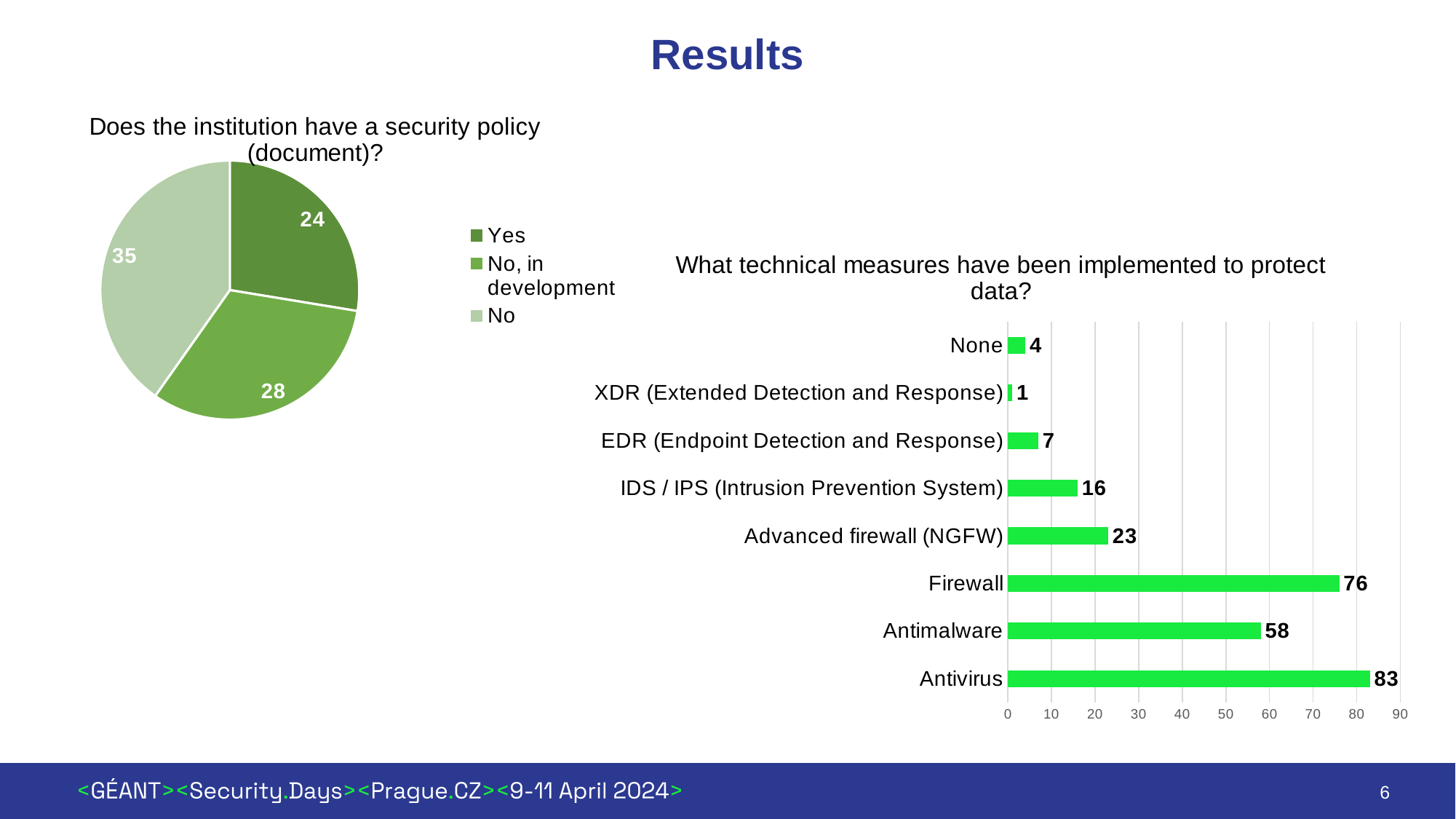
What kind of chart is 'What technical measures have been implemented to protect data?'? Bar chart In the bar chart 'What technical measures have been implemented to protect data?', what is the value for None? 4 In the bar chart 'What technical measures have been implemented to protect data?', which measure has the highest value? Antivirus In the pie chart 'Does the institution have a security policy (document)?', which category has the largest slice? No How many categories does the legend of the pie chart 'Does the institution have a security policy (document)?' list? 3 How many categories are shown in the bar chart 'What technical measures have been implemented to protect data?'? 8 In the bar chart 'What technical measures have been implemented to protect data?', what is the value for Firewall? 76 In the bar chart 'What technical measures have been implemented to protect data?', what is the difference between Antivirus and Antimalware? 25 In the bar chart 'What technical measures have been implemented to protect data?', which measure has the lowest value? XDR (Extended Detection and Response) In the bar chart 'What technical measures have been implemented to protect data?', which is larger: Advanced firewall (NGFW) or IDS / IPS (Intrusion Prevention System)? Advanced firewall (NGFW) In the pie chart 'Does the institution have a security policy (document)?', what is the value for 'Yes'? 24 In the pie chart 'Does the institution have a security policy (document)?', what is the difference between the 'No' and 'Yes' values? 11